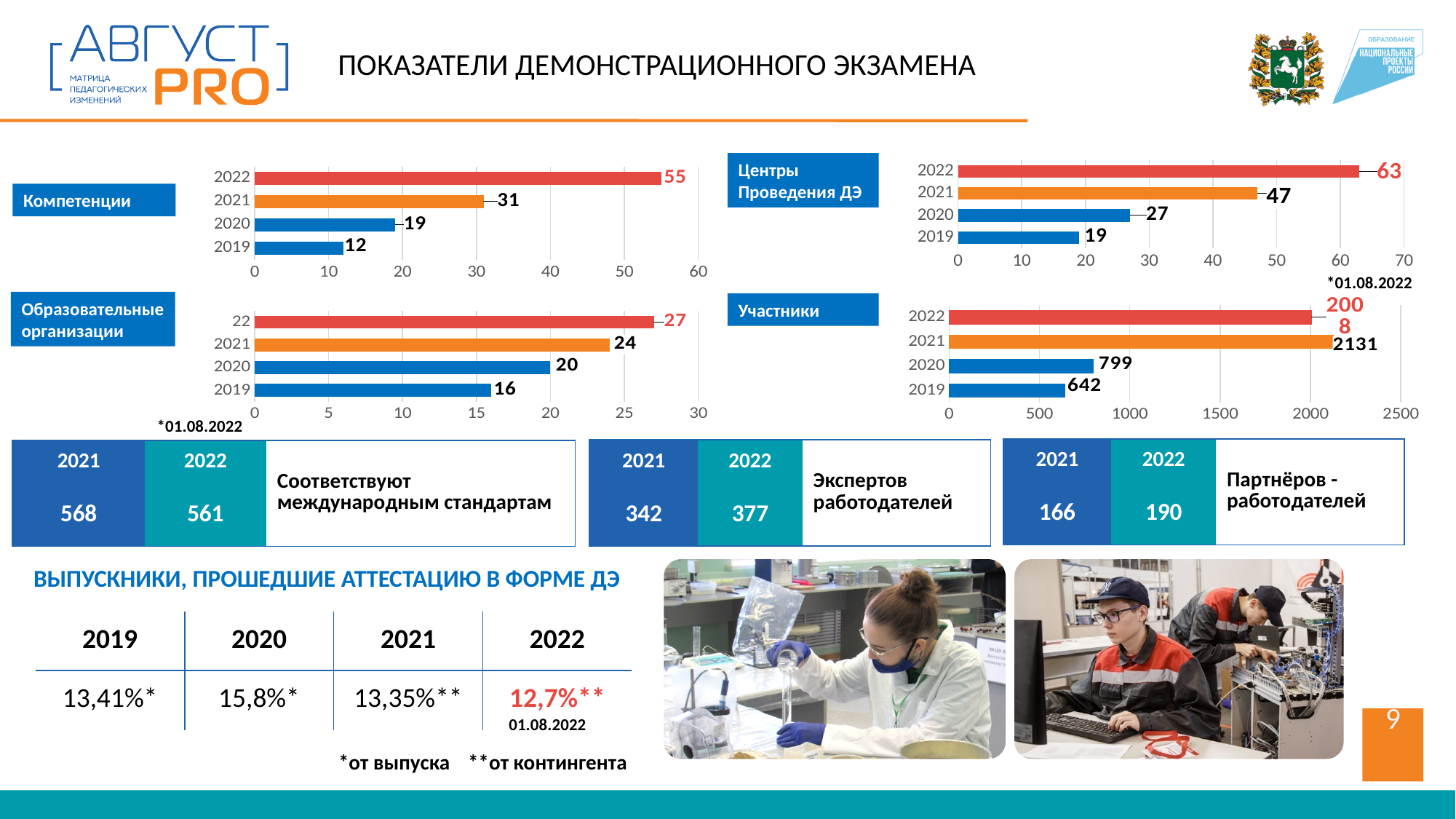
In the Участники chart, which is larger, the value for 2021 or the value for 2022? 2021 What kind of chart is the Компетенции chart? bar chart In the Центры Проведения ДЭ chart, what is the difference between the 2021 and 2020 values? 20 In the Компетенции chart, which year has the lowest value? 2019 In the Компетенции chart, what is the difference between the 2022 and 2021 values? 24 In the Компетенции chart, what is the value for 2022? 55 How many years are shown in the Центры Проведения ДЭ chart? 4 In the Образовательные организации chart, which year has the highest value? 22 In the Участники chart, is the value for 2020 greater or less than 1000? less In the Участники chart, what is the value for 2019? 642 In the Образовательные организации chart, what is the value for 2020? 20 In the Центры Проведения ДЭ chart, what is the value for 2021? 47